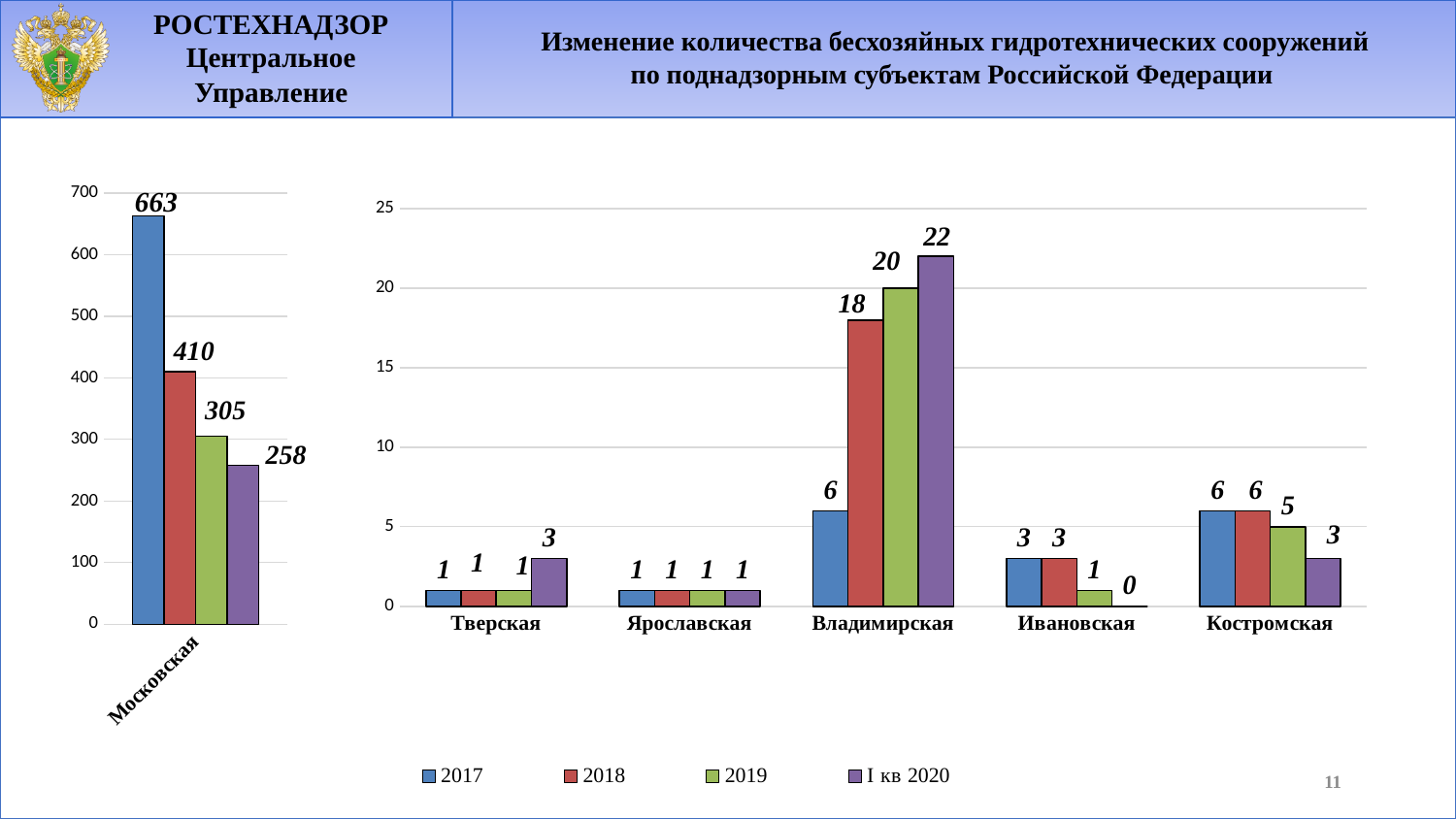
In the right chart, what is the value for Владимирская in 2019? 20 In the left chart (Московская), what is the value for I кв 2020? 258 What type of chart is the right chart? bar chart In the left chart (Московская), do the values rise or fall from 2017 to I кв 2020? fall In the right chart, what is the difference between the Владимирская values for I кв 2020 and 2017? 16 In the left chart (Московская), what is the difference between the 2017 value and the 2018 value? 253 How many series does the legend of the right chart list? 4 In the right chart, which is larger: the Костромская value for 2019 or the Тверская value for I кв 2020? Костромская value for 2019 In the right chart, which region has the highest value in I кв 2020? Владимирская In the left chart (Московская), what is the value for 2017? 663 How many regions are shown on the x axis of the right chart? 5 In the right chart, what is the value for Ивановская in I кв 2020? 0